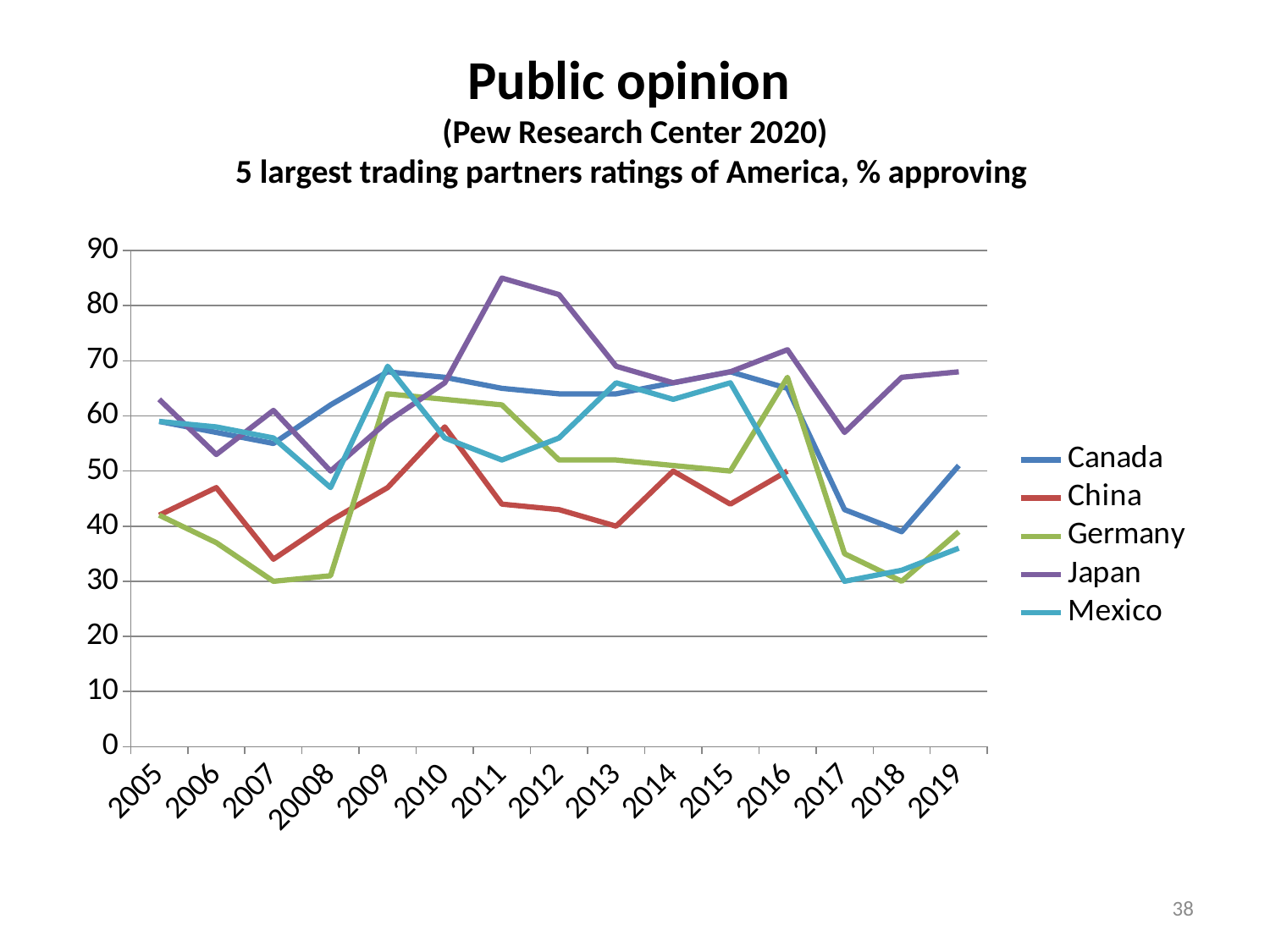
Which country has the lowest approval rating in 2017? Mexico Which is larger in 2012, the value for Japan or the value for China? Japan Which is larger in 2018, the value for Canada or the value for Mexico? Canada What kind of chart is shown on the slide? line chart Which country has the highest approval rating in 2011? Japan Which countries are listed in the legend? Canada, China, Germany, Japan, Mexico Is the value for Japan in 2011 greater or less than 80? greater How many years are shown along the x axis? 15 Is the value for China in 2007 greater or less than 40? less How many series does the legend list? 5 Does the value for Japan rise or fall from 2016 to 2017? fall Is the value for Mexico in 2009 greater or less than 60? greater